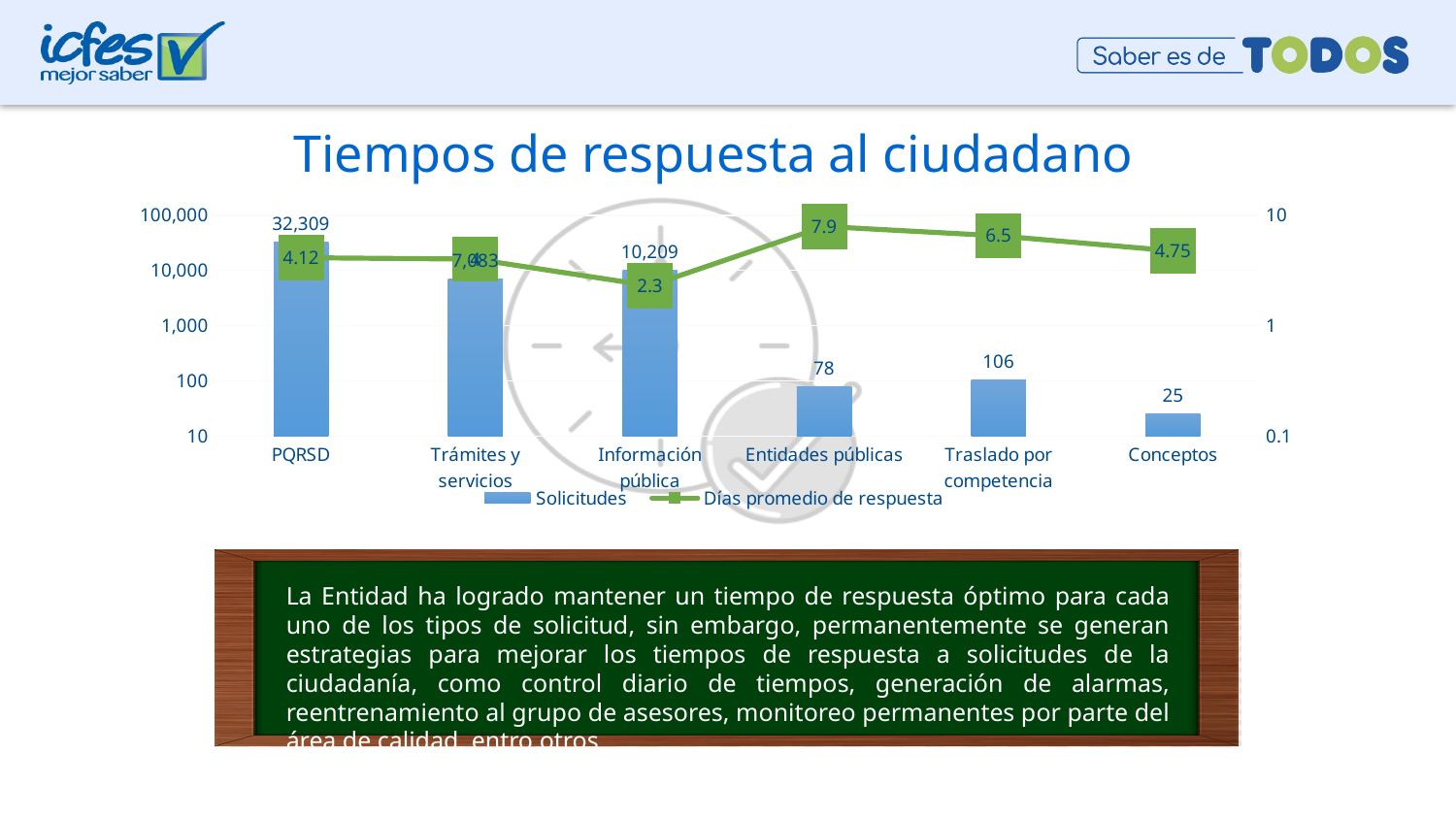
What is the number of Solicitudes for Información pública? 10,209 What is the number of Solicitudes for PQRSD? 32,309 How many categories are shown on the x axis? 6 What is the value of Días promedio de respuesta for Entidades públicas? 7.9 Which category has the lowest number of Solicitudes? Conceptos How many series does the legend list? 2 What is the difference in Solicitudes between Traslado por competencia and Entidades públicas? 28 Which has more Solicitudes, Traslado por competencia or Entidades públicas? Traslado por competencia What is the value of Días promedio de respuesta for Conceptos? 4.75 Which category has the highest number of Solicitudes? PQRSD Which category has the lowest Días promedio de respuesta? Información pública What kind of chart is shown on the slide? Combination bar and line chart